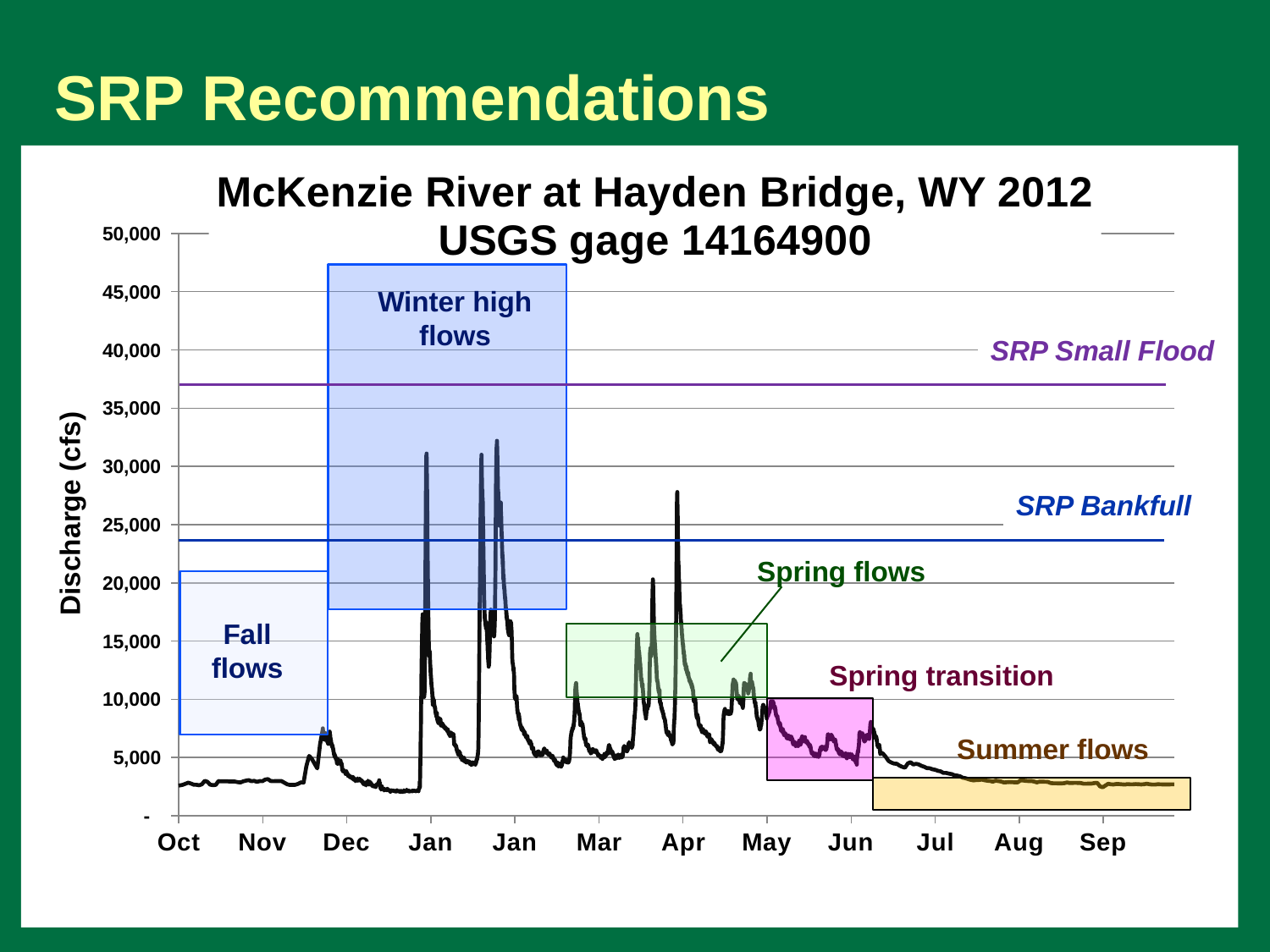
What is the label on the y-axis of the chart? Discharge (cfs) Does the discharge rise or fall from June through September? fall Is the highest discharge peak in the water year greater or less than 40,000 cfs? less Is the SRP Bankfull reference line greater or less than 25,000 cfs? less Is the SRP Small Flood reference line greater or less than 35,000 cfs? greater What kind of chart is shown on the slide? line chart Which is larger, the discharge peak in late December or the discharge peak in early April? late December What is the title of the chart? McKenzie River at Hayden Bridge, WY 2012 USGS gage 14164900 How many month labels are shown along the x-axis? 12 Which reference line is higher on the chart, SRP Small Flood or SRP Bankfull? SRP Small Flood